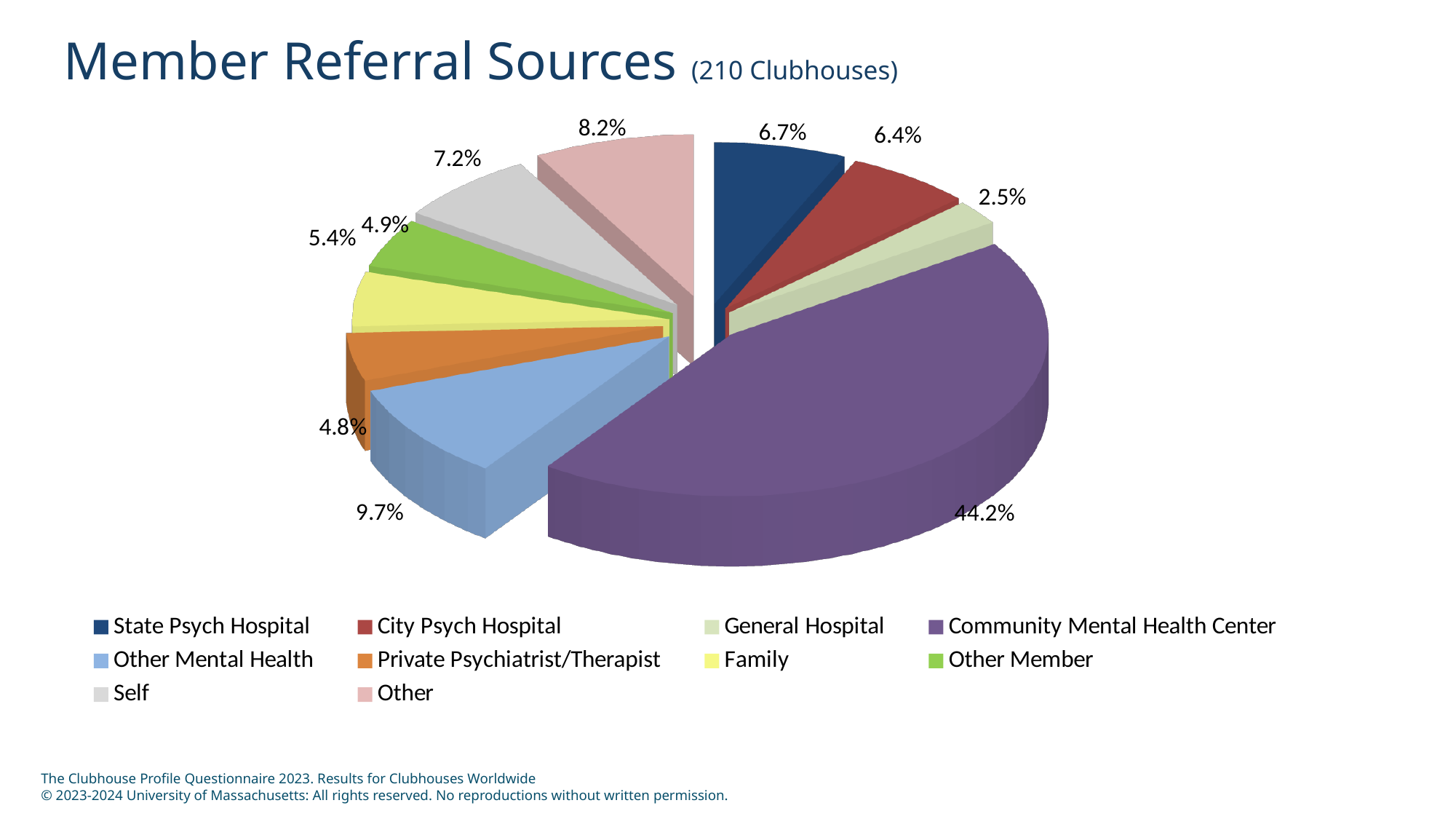
Which referral source has the largest share of the pie? Community Mental Health Center How many clubhouses does the chart title say the data covers? 210 What percentage of member referrals come from Community Mental Health Centers? 44.2% Which referral source has the smallest share of the pie? General Hospital What type of chart is used on this slide? Pie chart What percentage of referrals come from State Psych Hospitals? 6.7% How many referral source categories are shown in the pie chart? 10 What is the percentage for Self referrals? 7.2% What is the difference in percentage points between City Psych Hospital and General Hospital referrals? 3.9 What share of referrals is attributed to Other Mental Health sources? 9.7% Which is larger, the share for Family or the share for Other Member? Family Which is larger, the share for Other or the share for Self? Other